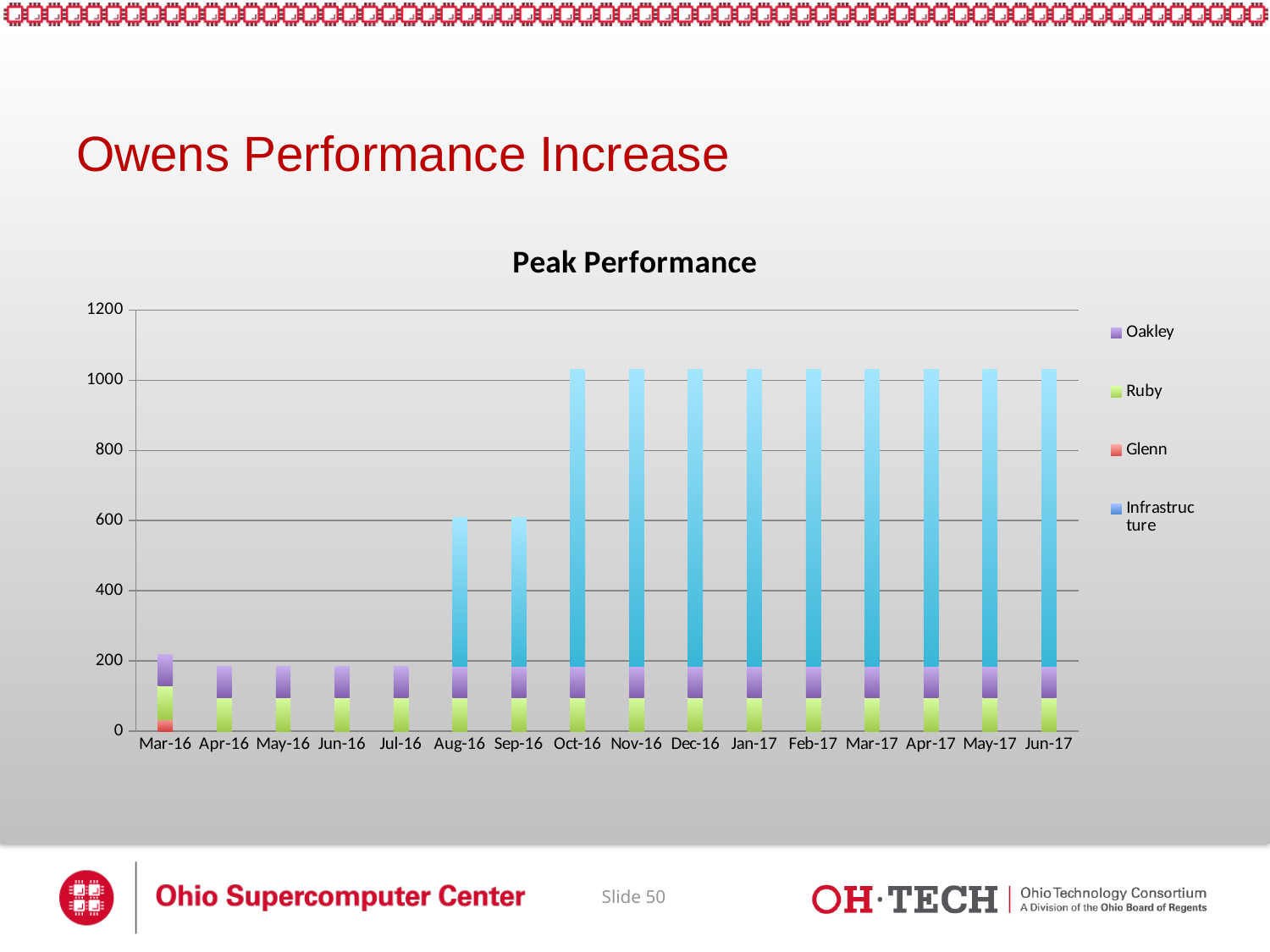
Is the total value for Oct-16 greater or less than 1000? greater What kind of chart is shown on the slide? Stacked bar chart Is the total value for Jul-16 greater or less than 400? less Which month has the larger total, Jul-16 or Aug-16? Aug-16 Is the total value for Sep-16 greater or less than 800? less Do the total values generally rise or fall from Mar-16 to Jun-17? Rise What is the title of the chart? Peak Performance How many months are shown along the x axis? 16 Which series are listed in the legend? Oakley, Ruby, Glenn, Infrastructure Which month has the larger total, Sep-16 or Oct-16? Oct-16 How many series does the legend list? 4